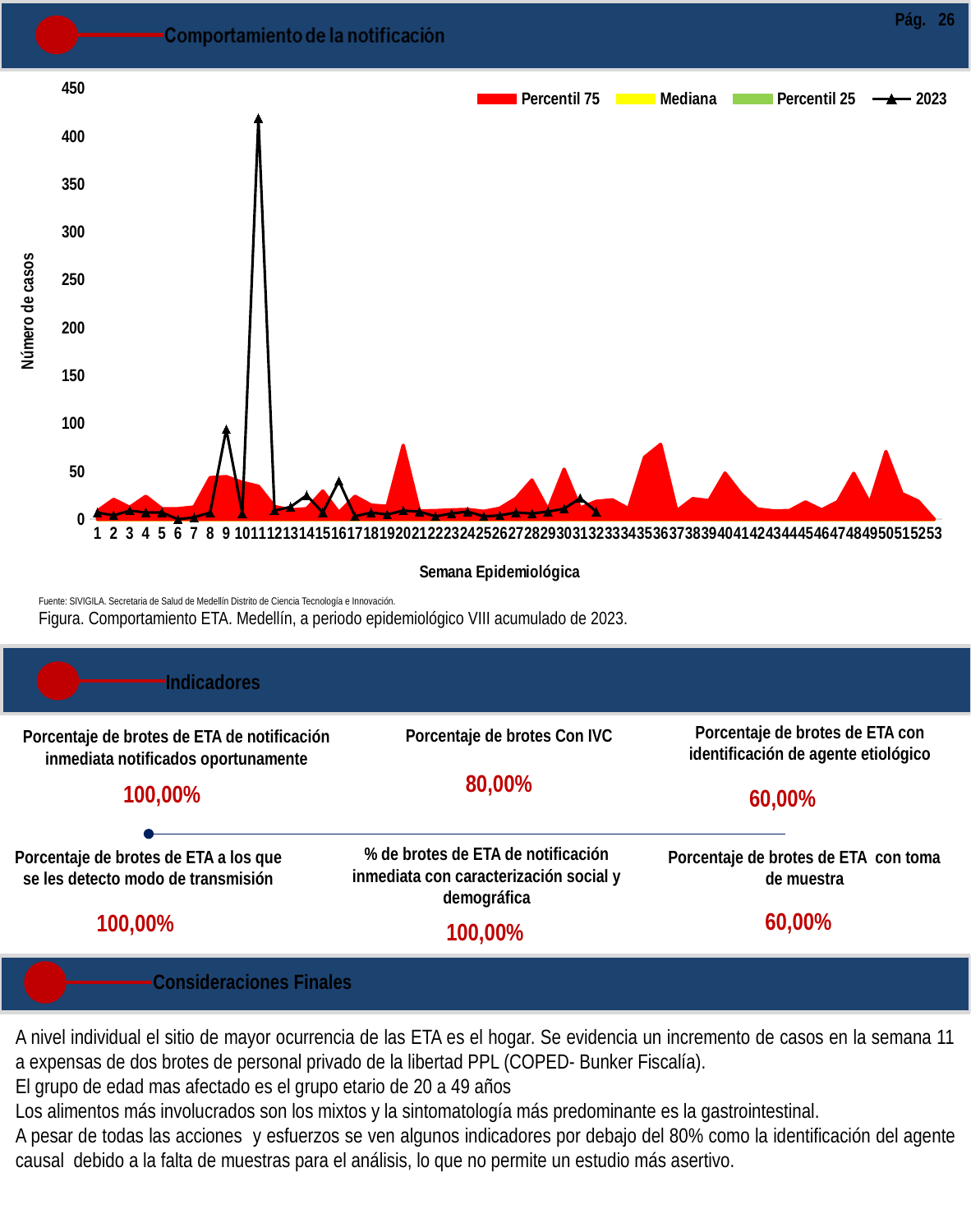
What colour represents the Mediana series in the legend? Yellow What is the label of the x axis? Semana Epidemiológica Is the 2023 value at week 9 greater or less than 50? greater Does the 2023 line rise or fall from week 11 to week 12? fall What is the highest value shown on the y axis? 450 Is the Percentil 75 value at week 20 greater or less than 100? less Is the 2023 value at week 16 greater or less than 100? less How many epidemiological weeks are shown on the x axis? 53 How many series does the chart legend list? 4 Which week has the larger 2023 value, week 9 or week 11? Week 11 In which epidemiological week does the 2023 line reach its highest value? Week 11